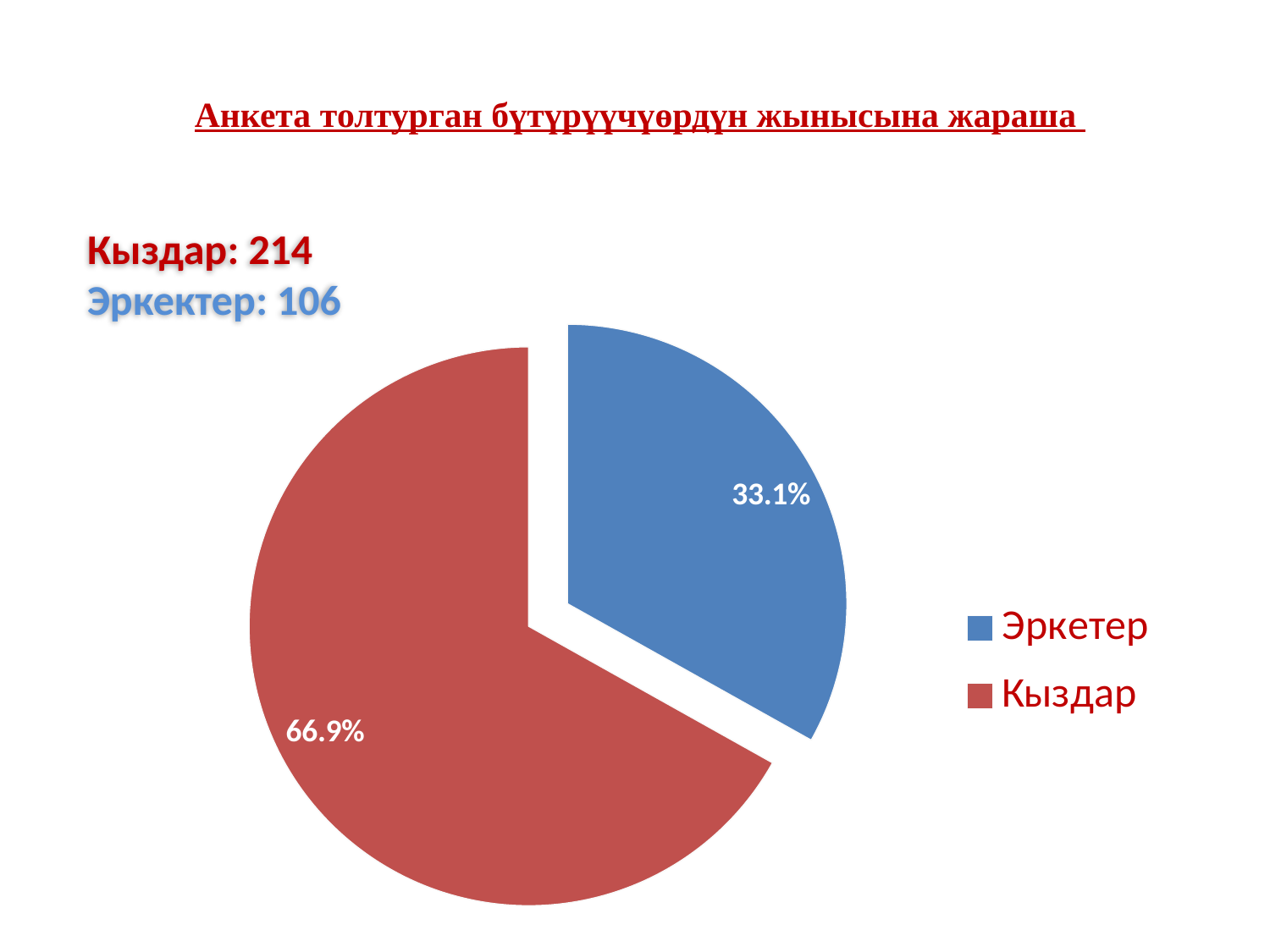
What colour is the Эркетер slice in the pie chart? blue What share of the pie does the Эркетер slice represent? 33.1% What kind of chart is shown on the slide? pie chart How many entries does the legend list? 2 Which slice of the pie is the largest? Кыздар What is the difference in percentage points between the Кыздар slice and the Эркетер slice? 33.8 Which is larger, the Кыздар slice or the Эркетер slice? Кыздар What colour is the Кыздар slice in the pie chart? red How many slices does the pie chart have? 2 What share of the pie does the Кыздар slice represent? 66.9% Is the share of the Эркетер slice greater or less than 50%? less Which slice of the pie is the smallest? Эркетер